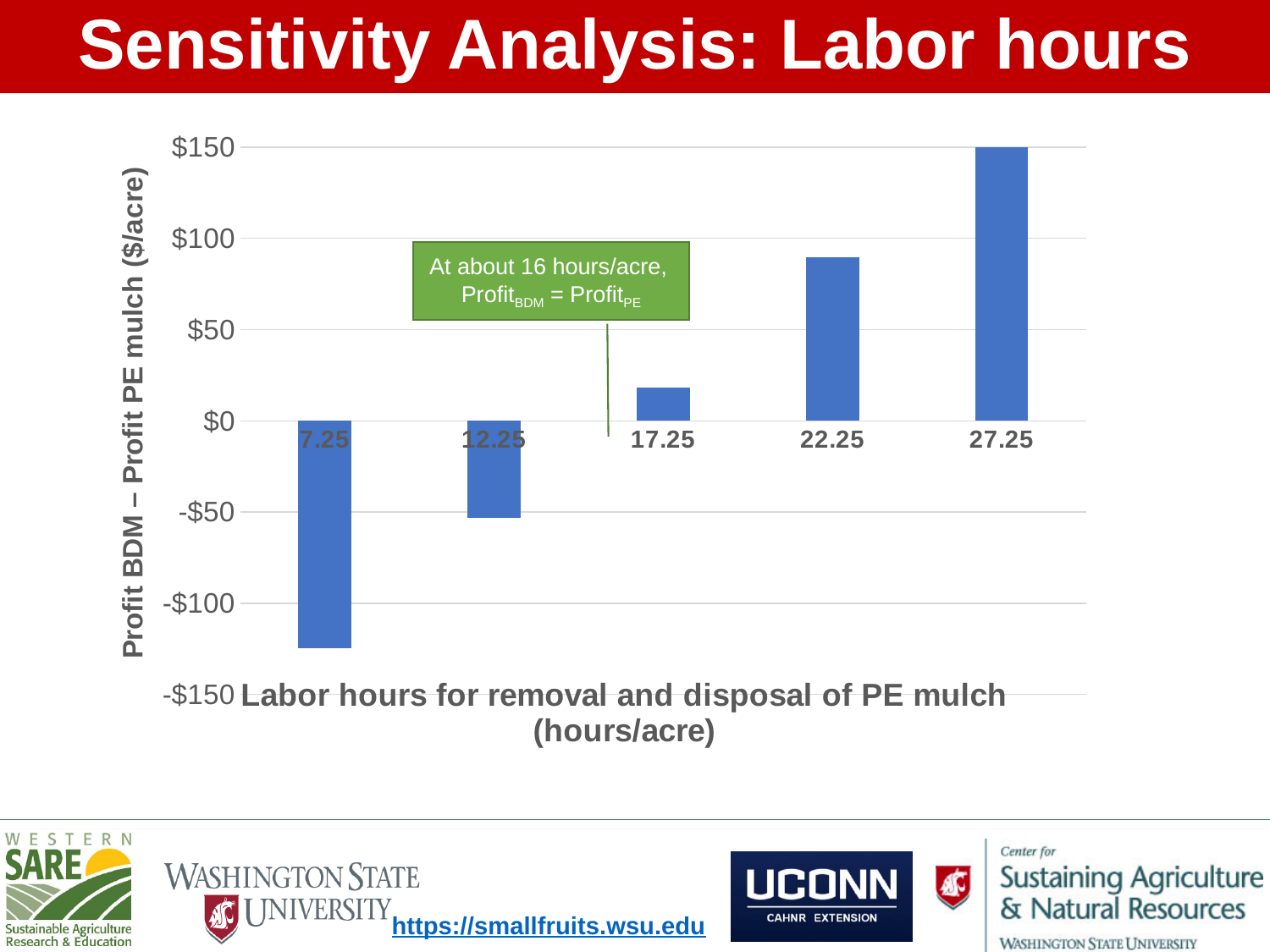
Is the value for 22.25 labor hours greater or less than $50? greater Which labor-hour category has the highest value of Profit BDM – Profit PE mulch? 27.25 Is the value for 12.25 labor hours greater or less than $0? less What kind of chart is shown on the slide? bar chart What is the title of the x axis? Labor hours for removal and disposal of PE mulch (hours/acre) Do the values rise or fall as labor hours increase along the x axis? rise Which has the larger value, 12.25 labor hours or 22.25 labor hours? 22.25 Is the value for 17.25 labor hours greater or less than $50? less Which labor-hour category has the lowest value of Profit BDM – Profit PE mulch? 7.25 According to the annotation on the chart, at about how many hours/acre does Profit BDM equal Profit PE? 16 hours/acre How many labor-hour categories are plotted on the x axis? 5